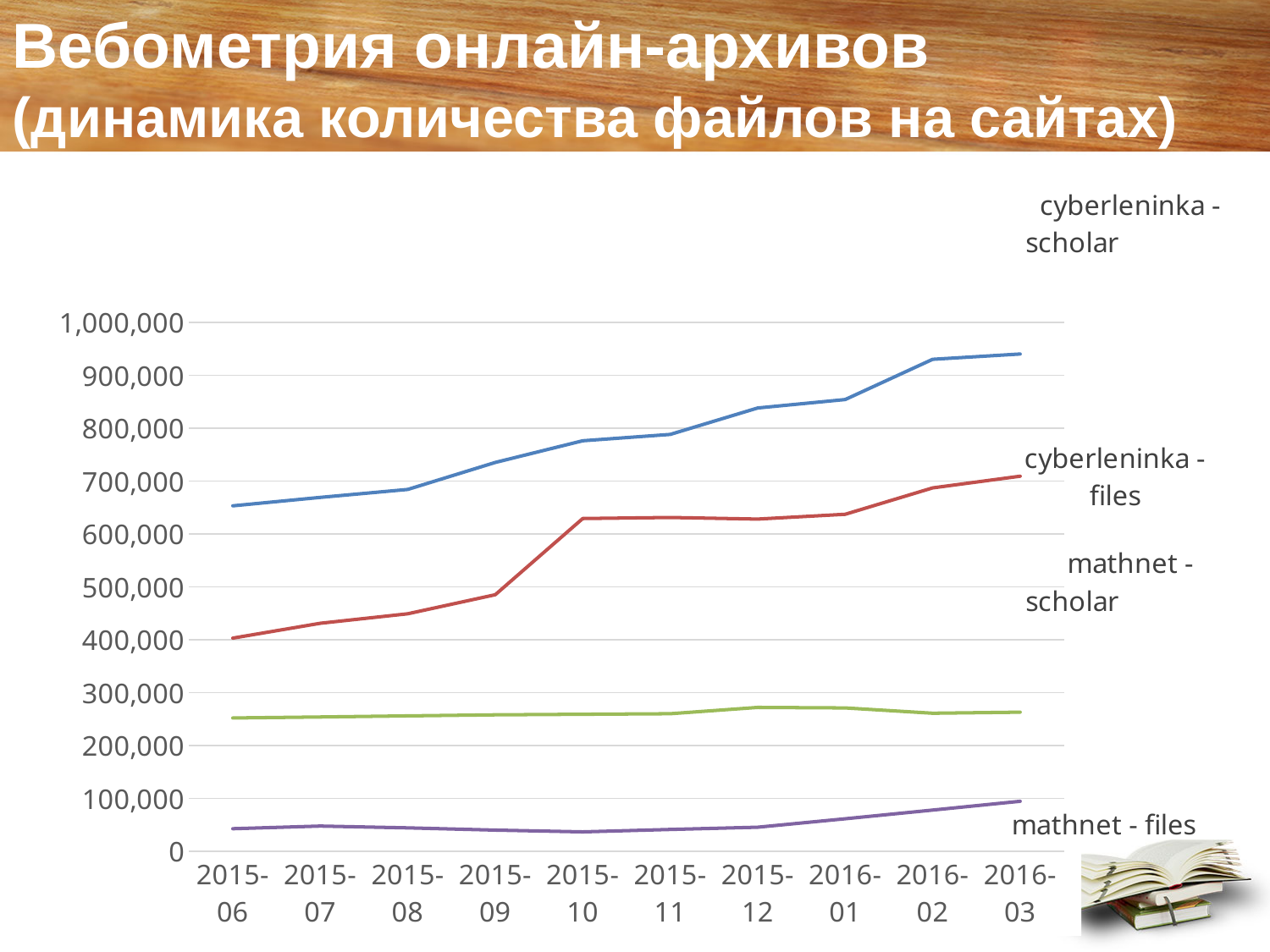
Which series has the highest value at 2016-03? cyberleninka - scholar Is the value for cyberleninka - scholar at 2015-06 greater or less than 600,000? greater Is the value for cyberleninka - scholar at 2016-03 greater or less than 900,000? greater How many time points are shown along the x axis? 10 What kind of chart is shown on the slide? line chart Does the cyberleninka - scholar line rise or fall from 2015-06 to 2016-03? rise At 2016-03, which is larger: cyberleninka - scholar or cyberleninka - files? cyberleninka - scholar What is the first line of the slide title? Вебометрия онлайн-архивов How many series are labelled on the chart? 4 Is the value for cyberleninka - files at 2015-06 greater or less than 500,000? less Which series has the lowest value at 2016-03? mathnet - files